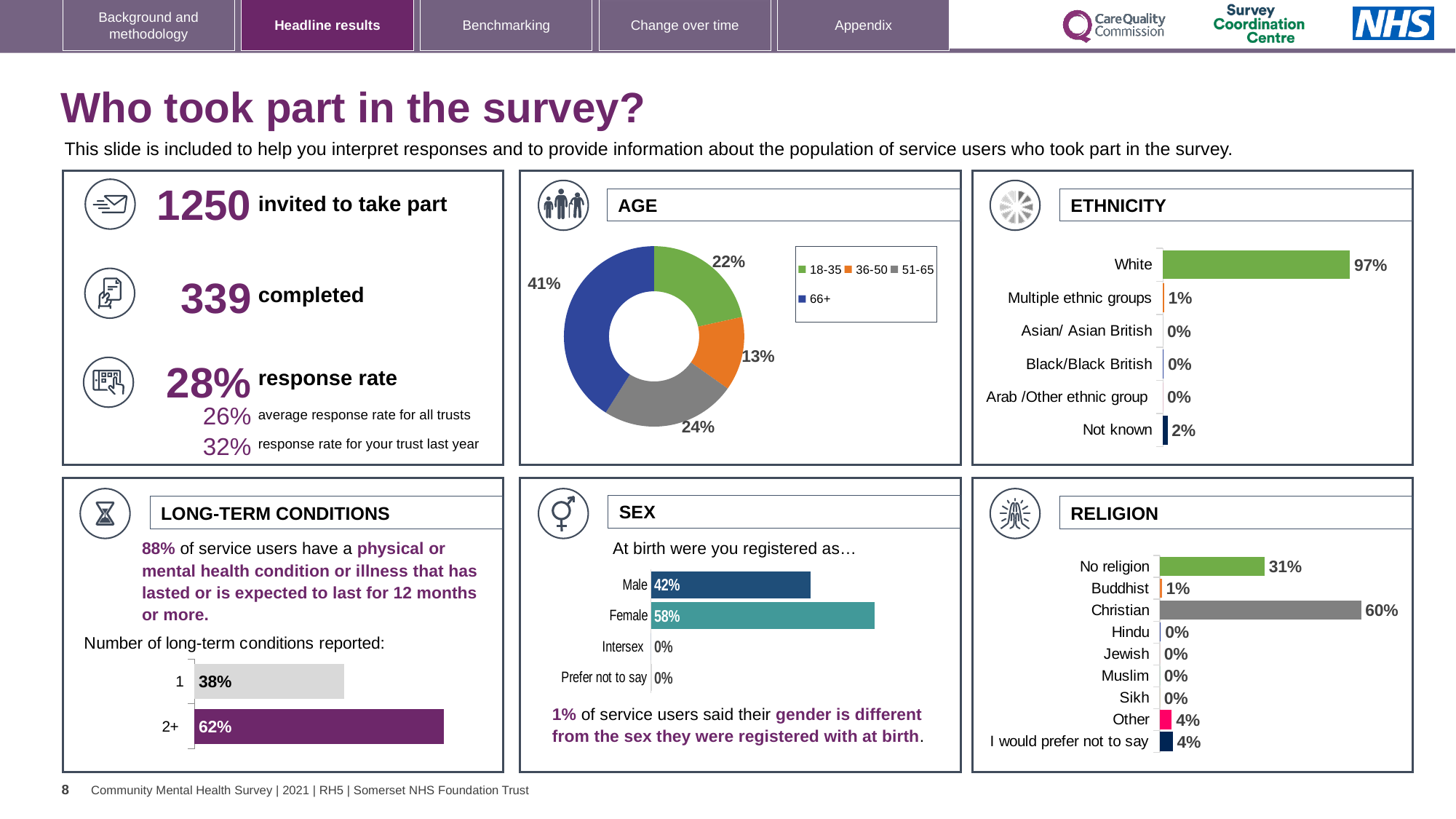
How many age groups does the legend of the AGE chart list? 4 In the RELIGION chart, which category has the highest value? Christian In the AGE chart, which age group has the smallest share? 36-50 In the SEX chart, what is the difference between the Female and Male values? 16% In the SEX chart, which is larger, Male or Female? Female What kind of chart is the AGE chart? Donut chart How many categories are shown in the ETHNICITY chart? 6 In the ETHNICITY chart, what is the value for White? 97% In the ETHNICITY chart, what is the value for Not known? 2% In the LONG-TERM CONDITIONS chart, what percentage reported 2+ conditions? 62% In the RELIGION chart, what is the value for No religion? 31% In the AGE chart, what percentage of respondents were aged 66+? 41%